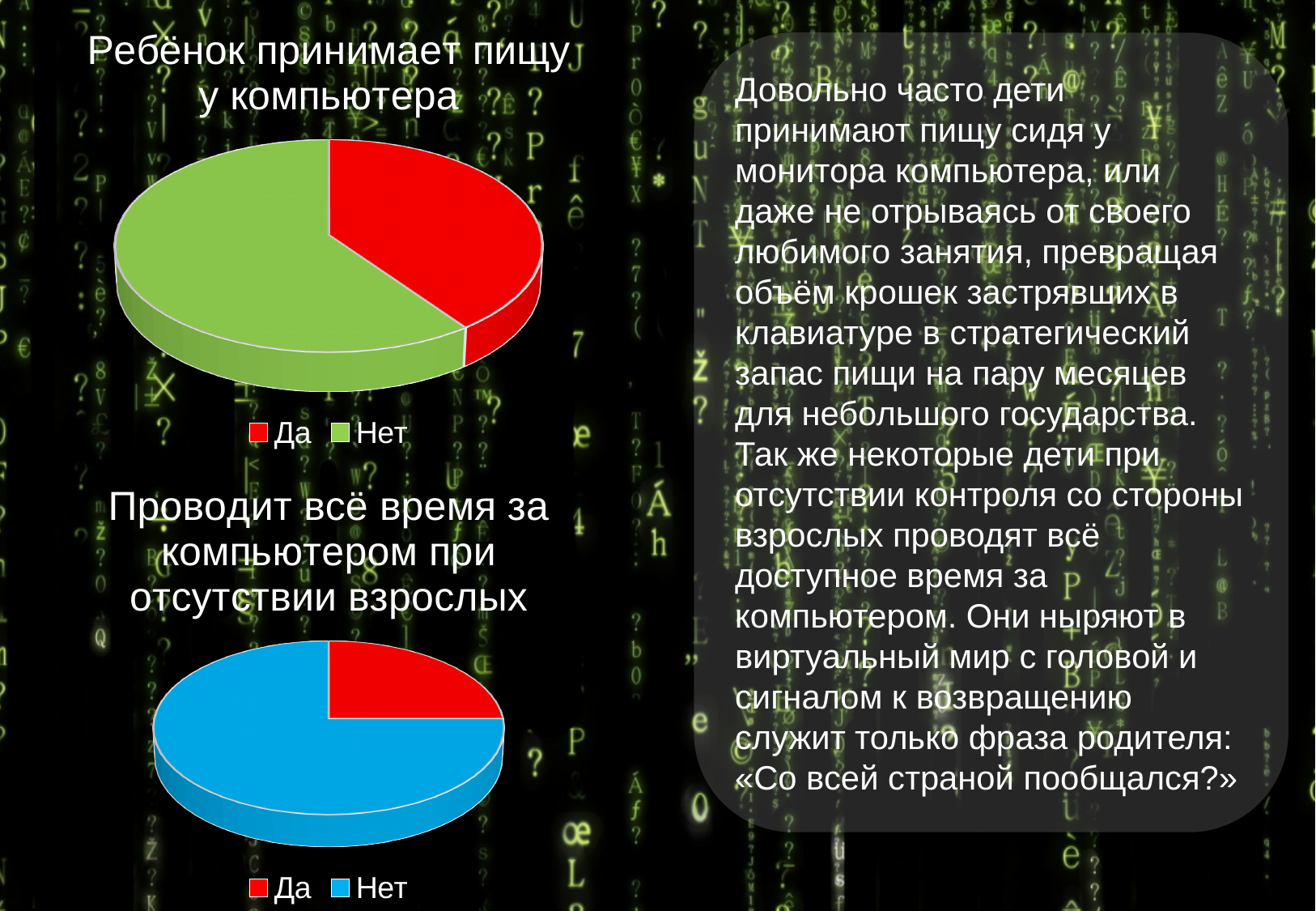
How many slices does the chart "Ребёнок принимает пищу у компьютера" have? 2 In the chart "Ребёнок принимает пищу у компьютера", which category has the largest slice? Нет In the chart "Проводит всё время за компьютером при отсутствии взрослых", what colour is the slice for Нет? blue In the chart "Ребёнок принимает пищу у компьютера", what colour is the slice for Да? red How many entries does the legend of the chart "Проводит всё время за компьютером при отсутствии взрослых" list? 2 In the chart "Ребёнок принимает пищу у компьютера", is the slice for Да larger or smaller than the slice for Нет? smaller In the chart "Проводит всё время за компьютером при отсутствии взрослых", which category has the largest slice? Нет In the chart "Ребёнок принимает пищу у компьютера", which category has the smallest slice? Да What kind of chart is used for "Ребёнок принимает пищу у компьютера"? pie chart In the chart "Проводит всё время за компьютером при отсутствии взрослых", which category has the smallest slice? Да What kind of chart is used for "Проводит всё время за компьютером при отсутствии взрослых"? pie chart In the chart "Проводит всё время за компьютером при отсутствии взрослых", is the slice for Нет larger or smaller than the slice for Да? larger